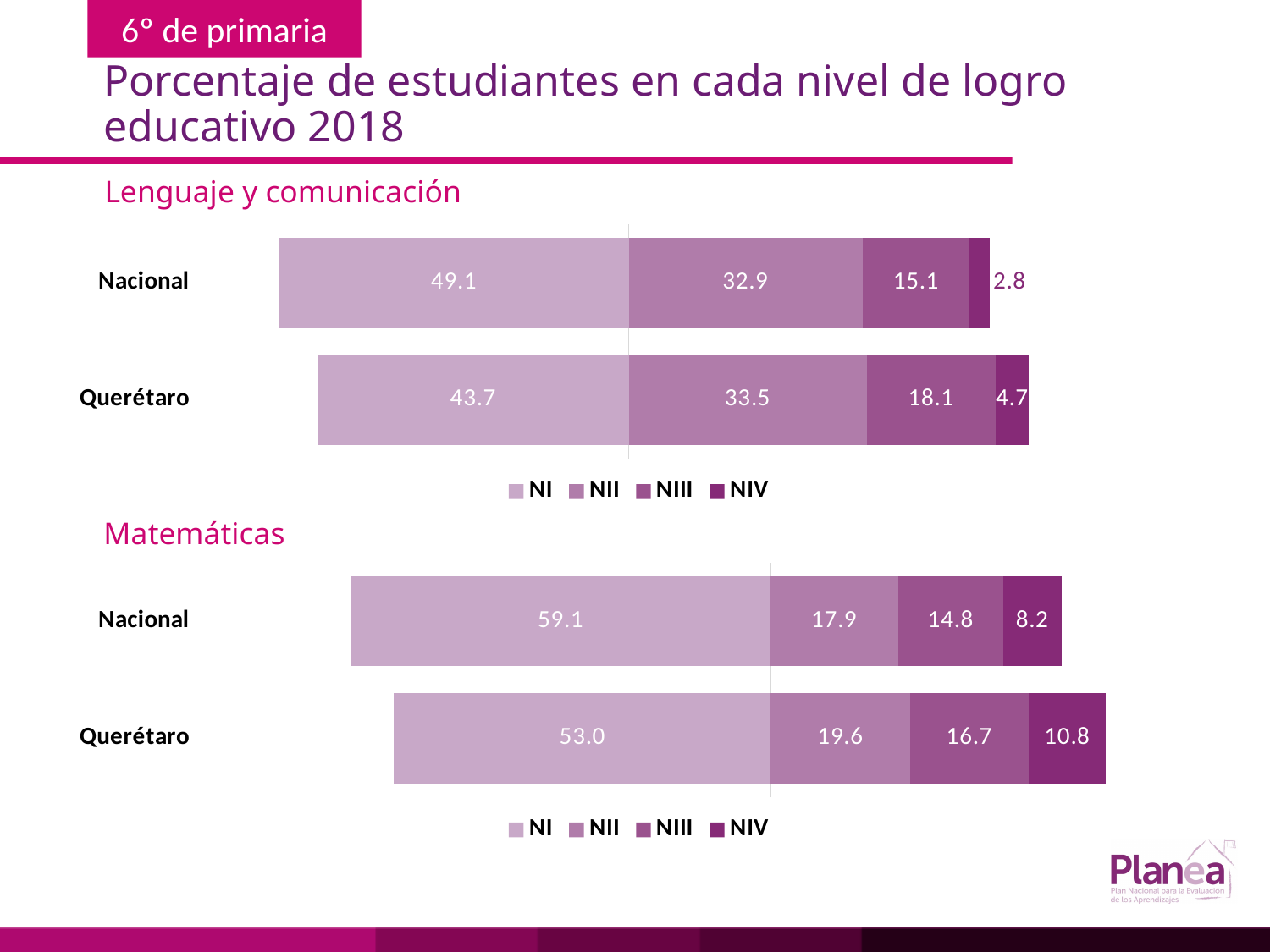
In the Matemáticas chart, what is the NII value for Querétaro? 19.6 In the Lenguaje y comunicación chart, which series has the highest value for Querétaro? NI What kind of chart is the Matemáticas chart? Stacked bar chart In the Matemáticas chart, what is the total of the Querétaro bar? 100.1 In the Lenguaje y comunicación chart, what is the NI value for Nacional? 49.1 How many categories are shown in the Lenguaje y comunicación chart? 2 In the Matemáticas chart, which series has the lowest value for Nacional? NIV In the Matemáticas chart, what is the NIII value for Nacional? 14.8 In the Lenguaje y comunicación chart, what is the difference between the NI values for Nacional and Querétaro? 5.4 In the Lenguaje y comunicación chart, what is the NIV value for Querétaro? 4.7 In the Matemáticas chart, which has the larger NIV value, Nacional or Querétaro? Querétaro How many series does the legend of the Matemáticas chart list? 4